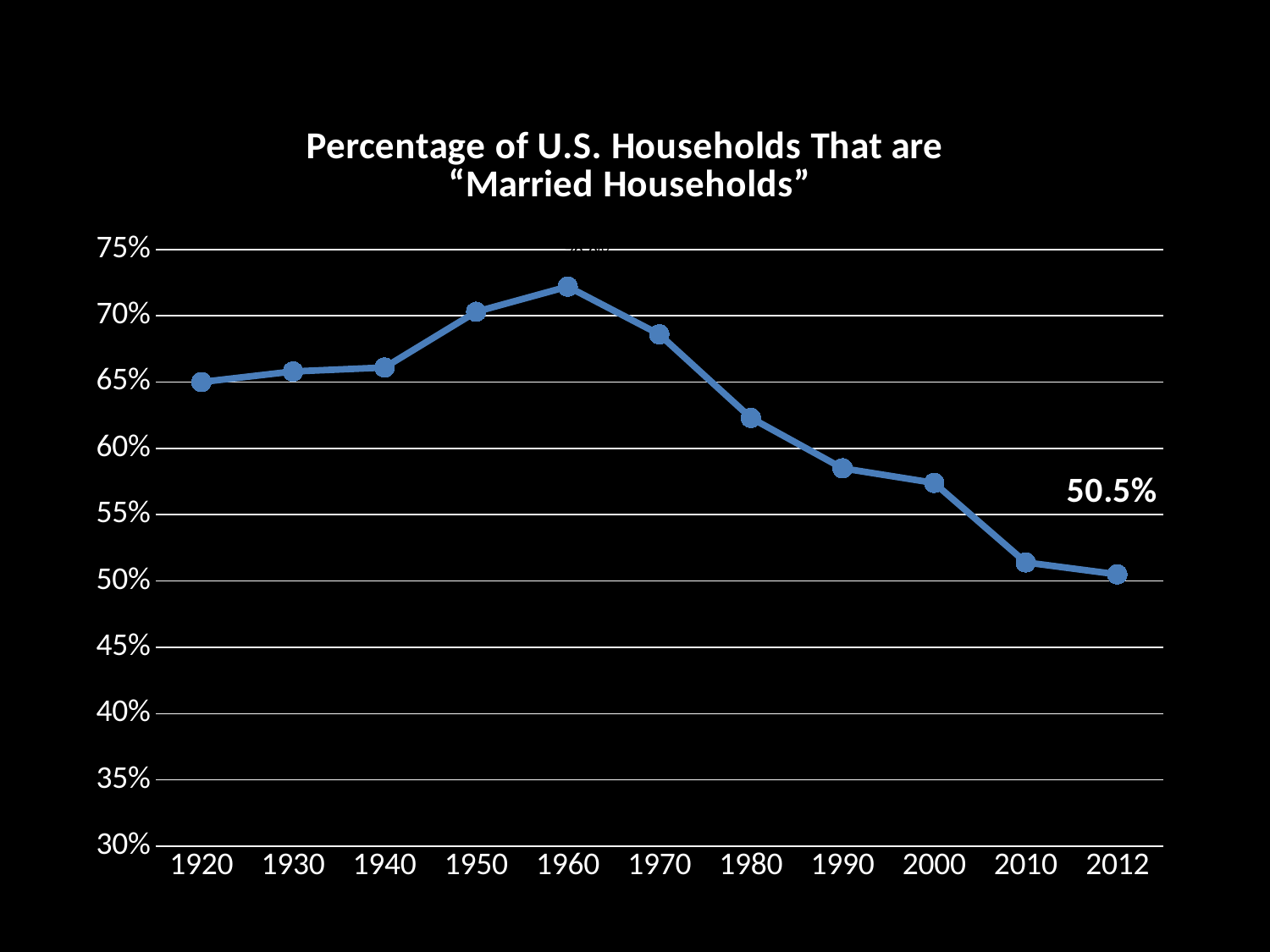
How many data points are plotted on the line? 11 What is the title of the chart? Percentage of U.S. Households That are "Married Households" Do the values rise or fall from 1960 to 2012? fall Is the value for 1970 greater or less than 70%? less Do the values rise or fall from 1920 to 1960? rise Is the value for 1990 greater or less than 60%? less Which year has a higher value, 1950 or 1990? 1950 Is the value for 1980 greater or less than 60%? greater Which year has the highest percentage of married households? 1960 What kind of chart is shown on the slide? line chart Which year has the lowest percentage of married households? 2012 What is the percentage of married households in 2012? 50.5%